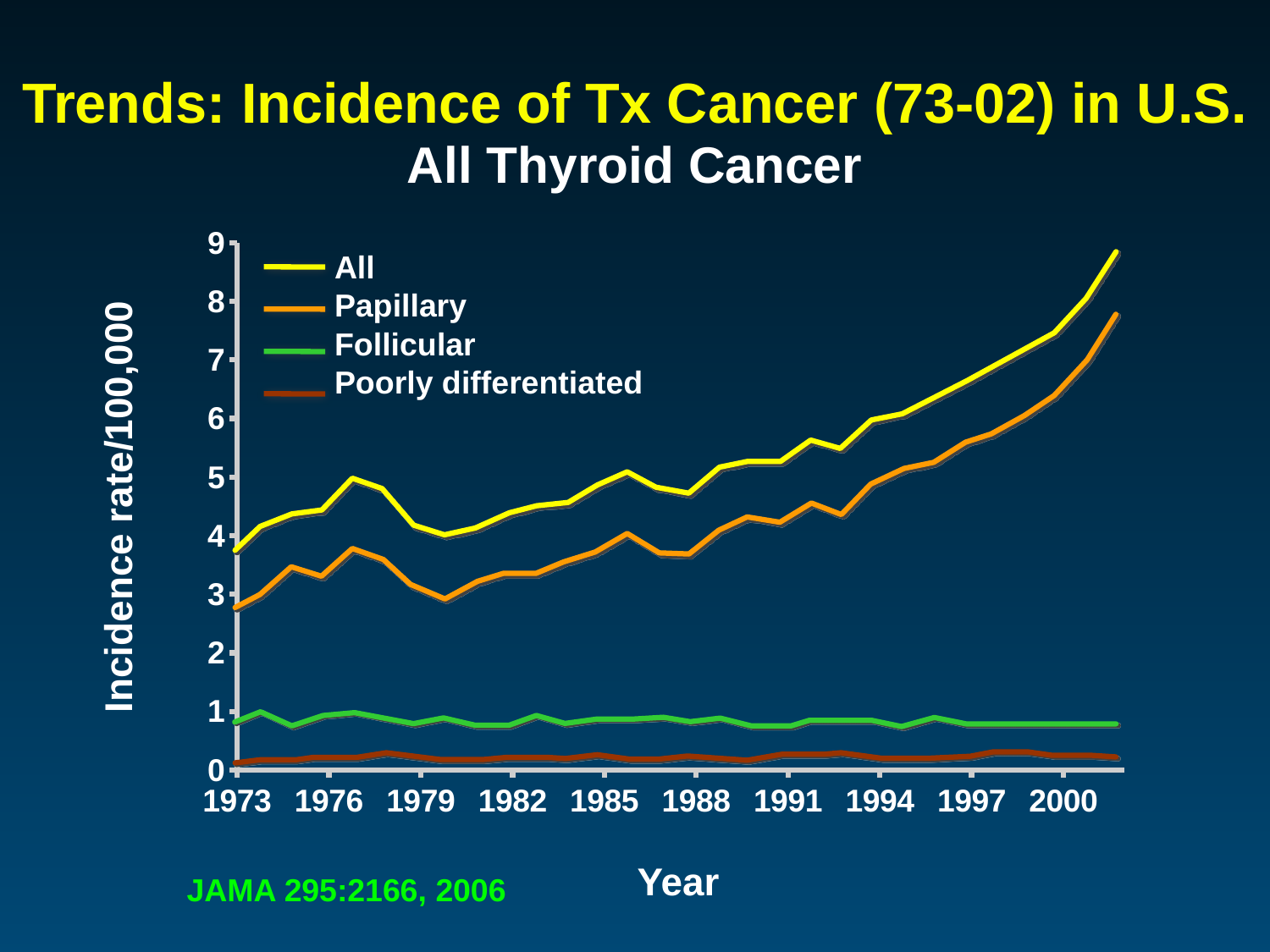
In 1991, which is larger: Follicular or Poorly differentiated? Follicular In 2002, which is larger: the All series or the Papillary series? All Is the value for Papillary in 1973 greater or less than 3? less Is the value for the All series at the end of the chart (2002) greater or less than 8? greater What is the label of the y axis? Incidence rate/100,000 Which series has the lowest incidence rate across the chart? Poorly differentiated Which series has the highest incidence rate across the chart? All Is the value for Follicular in 1985 greater or less than 2? less What kind of chart is shown on the slide? Line chart How many series does the legend list? 4 Does the incidence rate for the All series rise or fall from 1973 to 2002? Rise